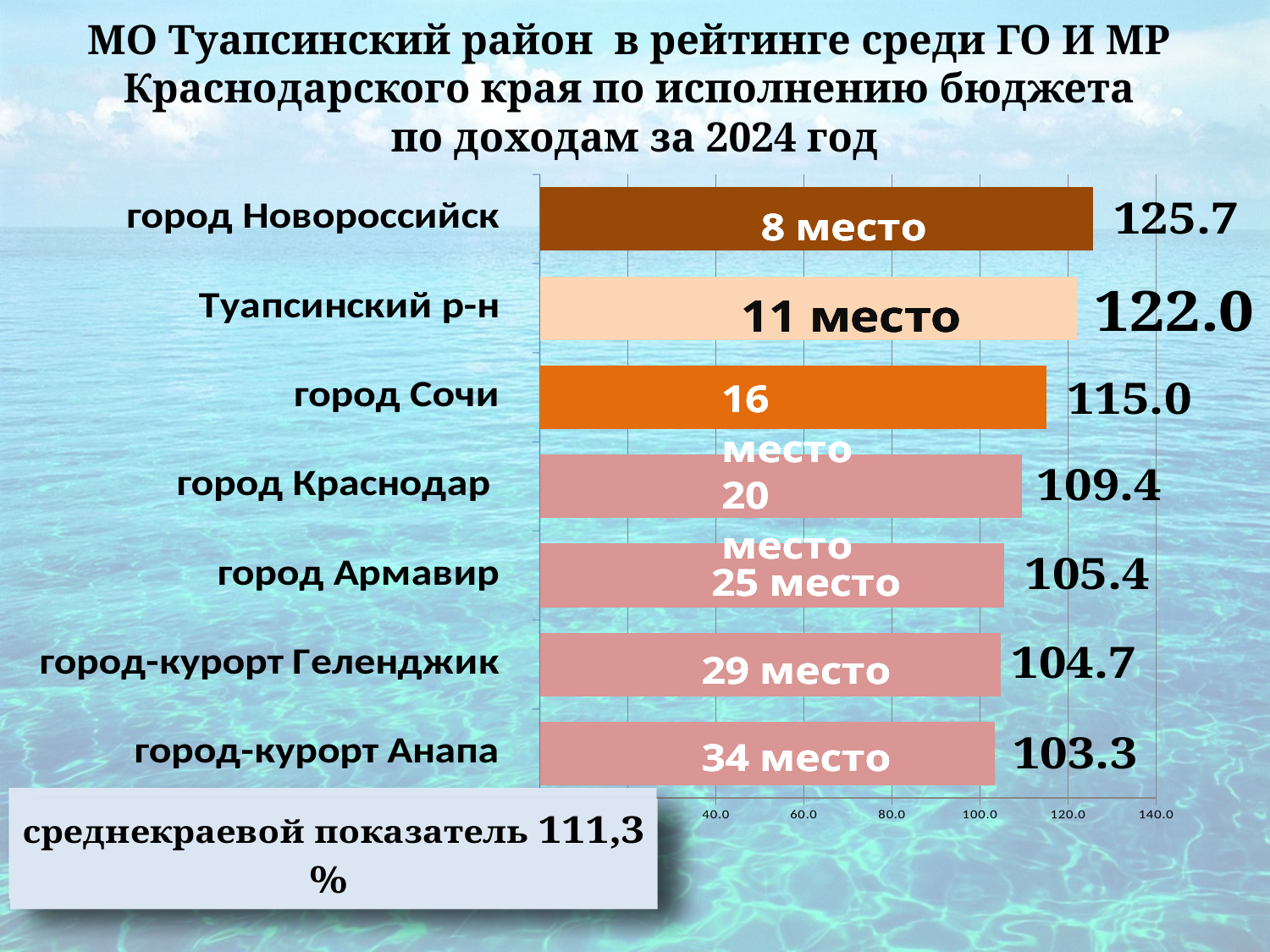
What is the difference between the values for город Новороссийск and Туапсинский р-н? 3.7 What is the value shown for Туапсинский р-н? 122.0 What kind of chart is shown on the slide? bar chart Which category has the lowest value? город-курорт Анапа What is the value shown for город-курорт Анапа? 103.3 What is the value shown for город Новороссийск? 125.7 What is the value shown for город Краснодар? 109.4 What rank (место) is printed on the bar for Туапсинский р-н? 11 место Which has a larger value, город Армавир or город-курорт Геленджик? город Армавир Which category has the highest value? город Новороссийск How many categories are shown in the chart? 7 What is the difference between the values for Туапсинский р-н and город Сочи? 7.0